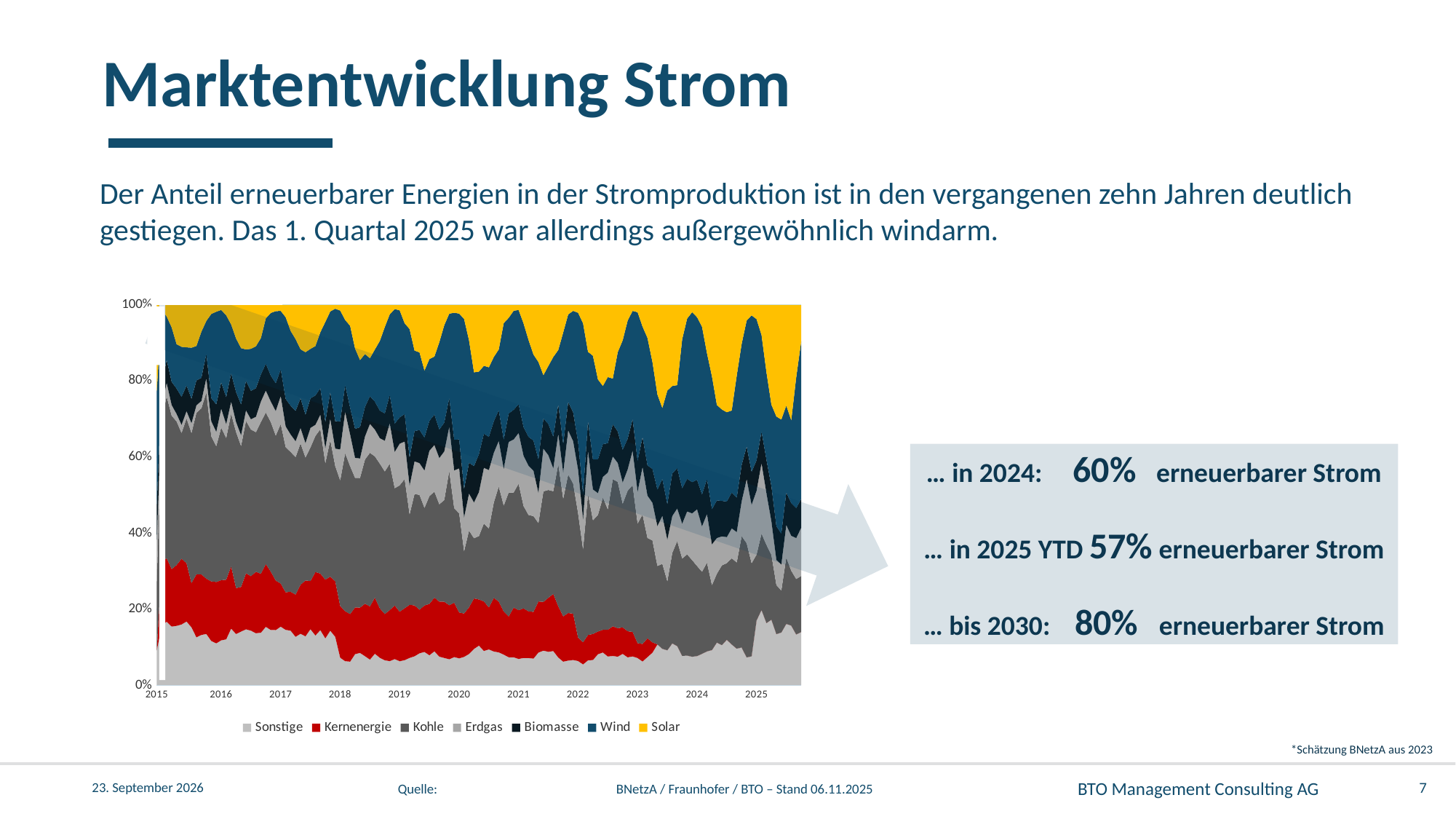
How many year labels are shown on the x axis of the chart? 11 What is the highest value shown on the y axis of the chart? 100% How many series does the chart's legend list? 7 Does the share of Solar rise or fall from 2015 to 2025 in the chart? Rise Which colour represents Solar in the chart's legend? Yellow Does the share of Kernenergie rise or fall from 2015 to 2023 in the chart? Fall What is the first year shown on the x axis of the chart? 2015 What is the last year labelled on the x axis of the chart? 2025 Which series is plotted at the bottom of the stacked area chart? Sonstige Which series is plotted at the top of the stacked area chart? Solar What kind of chart is shown on the slide? Stacked area chart Which series in the chart disappears from the stack around 2023? Kernenergie